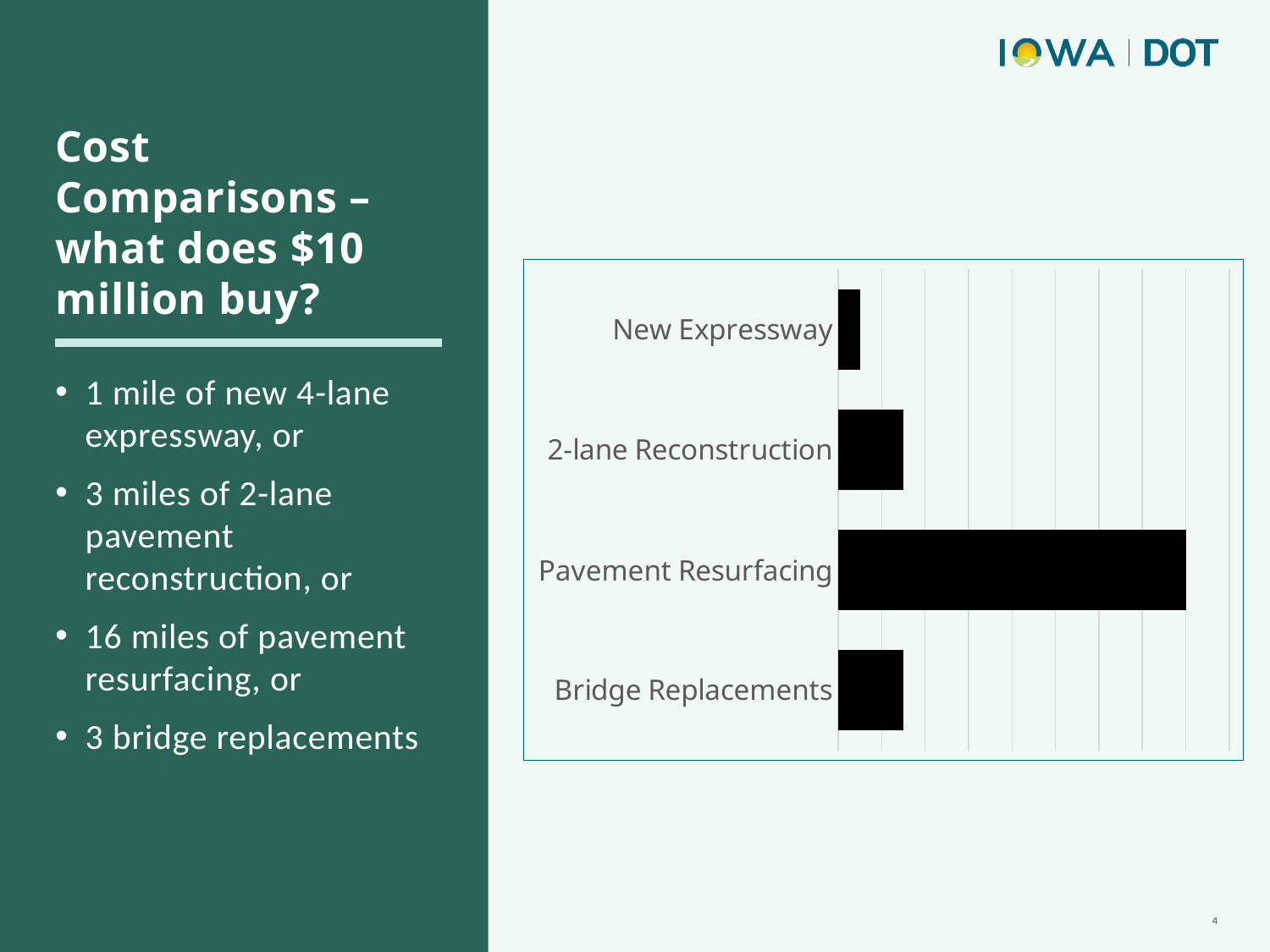
Which category has the longest bar in the chart? Pavement Resurfacing Which category is listed at the bottom of the chart? Bridge Replacements Which bar is longer: New Expressway or Bridge Replacements? Bridge Replacements Which bar is longer: Pavement Resurfacing or 2-lane Reconstruction? Pavement Resurfacing What kind of chart is shown on the slide? bar chart How many categories does the chart show? 4 Which bar is longer: Pavement Resurfacing or Bridge Replacements? Pavement Resurfacing Are the bars in the chart drawn horizontally or vertically? horizontally What colour are the bars in the chart? black Which category has the shortest bar in the chart? New Expressway Which category is listed at the top of the chart? New Expressway